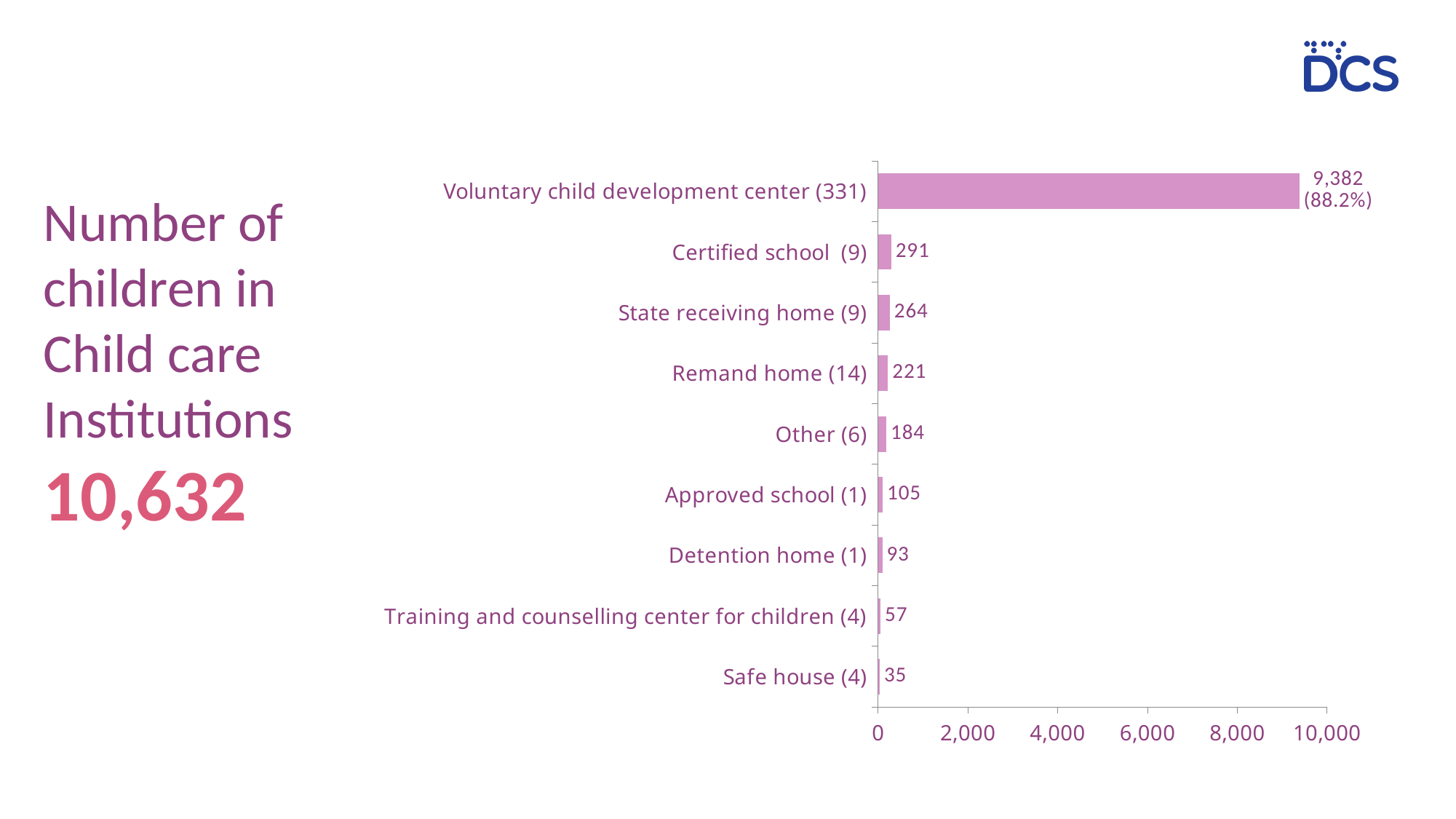
What is the value for Remand home (14)? 221 How many categories are shown in the chart? 9 Which category has the lowest number of children? Safe house (4) Is the value for Voluntary child development center (331) greater or less than 8,000? greater What is the difference between the values for Certified school (9) and State receiving home (9)? 27 What kind of chart is shown on the slide? bar chart What percentage share is printed next to the Voluntary child development center bar? 88.2% What is the value for Safe house (4)? 35 Which is larger, the value for Approved school (1) or Detention home (1)? Approved school (1) What is the value for Certified school (9)? 291 Which category has the highest number of children? Voluntary child development center (331) How many children are in Voluntary child development centers (331)? 9,382